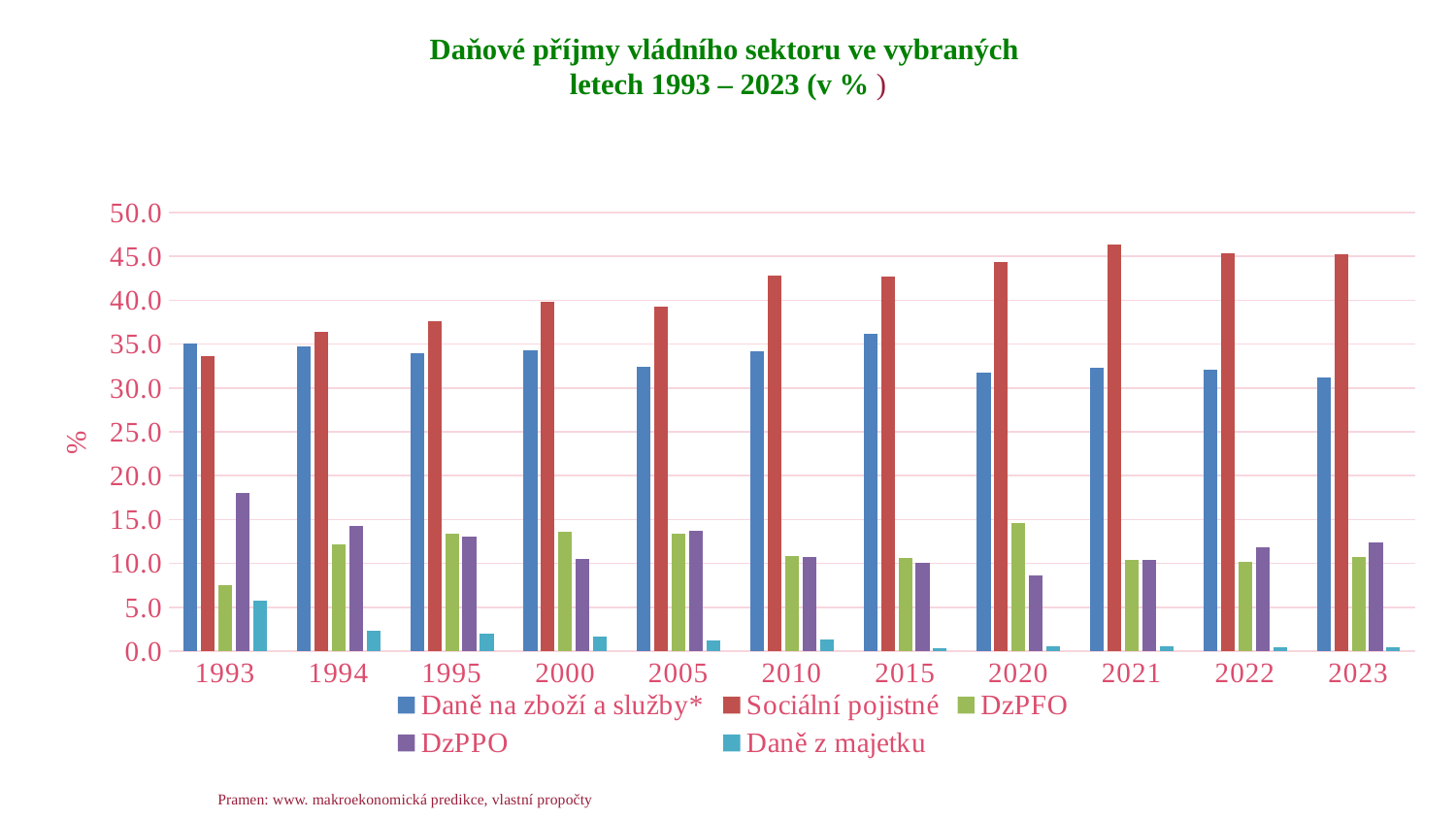
In which year is the value for DzPPO the highest? 1993 In which year is the value for Daně z majetku the highest? 1993 Does the value for Sociální pojistné generally rise or fall from 1993 to 2023? rise How many series does the legend list? 5 How many years are shown on the x axis? 11 Is the value for Daně na zboží a služby* in 2023 greater or less than 30.0? greater In which year is the value for Daně na zboží a služby* the highest? 2015 In 1993, which is larger: Daně na zboží a služby* or Sociální pojistné? Daně na zboží a služby* In 2023, which is larger: Sociální pojistné or Daně na zboží a služby*? Sociální pojistné Is the value for Sociální pojistné in 2021 greater or less than 45.0? greater What kind of chart is shown on the slide? bar chart